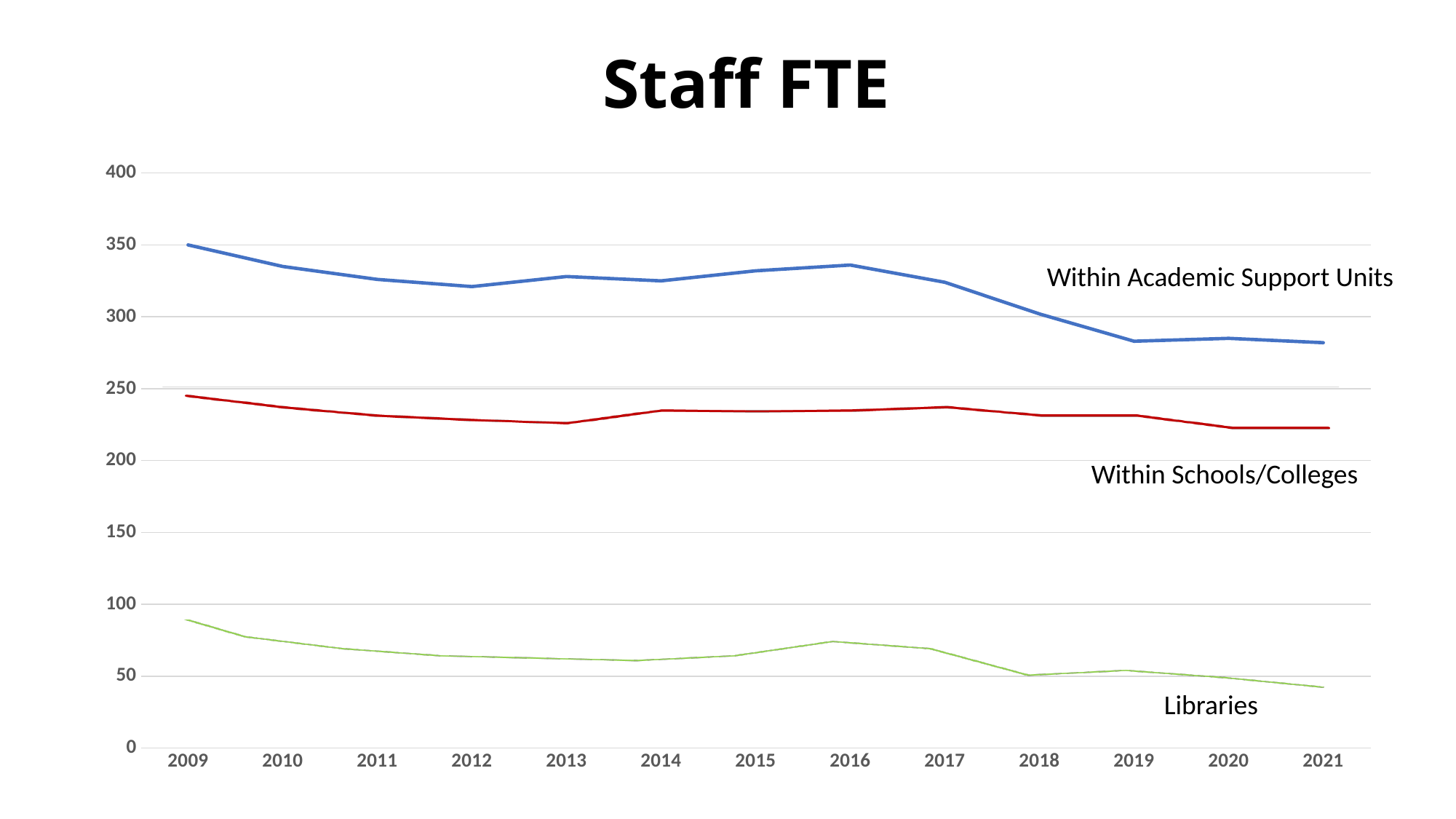
Which series has the lowest values across all years? Libraries Is the value for Libraries in 2009 greater or less than 100? less Does the Within Academic Support Units line rise or fall from 2017 to 2019? fall What type of chart is shown on the slide? line chart What is the title of the chart? Staff FTE Which is larger for Within Schools/Colleges: the value in 2009 or the value in 2021? 2009 How many years are shown along the x axis? 13 Is the value for Libraries in 2021 greater or less than 50? less Is the value for Within Academic Support Units in 2021 greater or less than 300? less Which series has the highest values across all years? Within Academic Support Units How many data series are plotted on the chart? 3